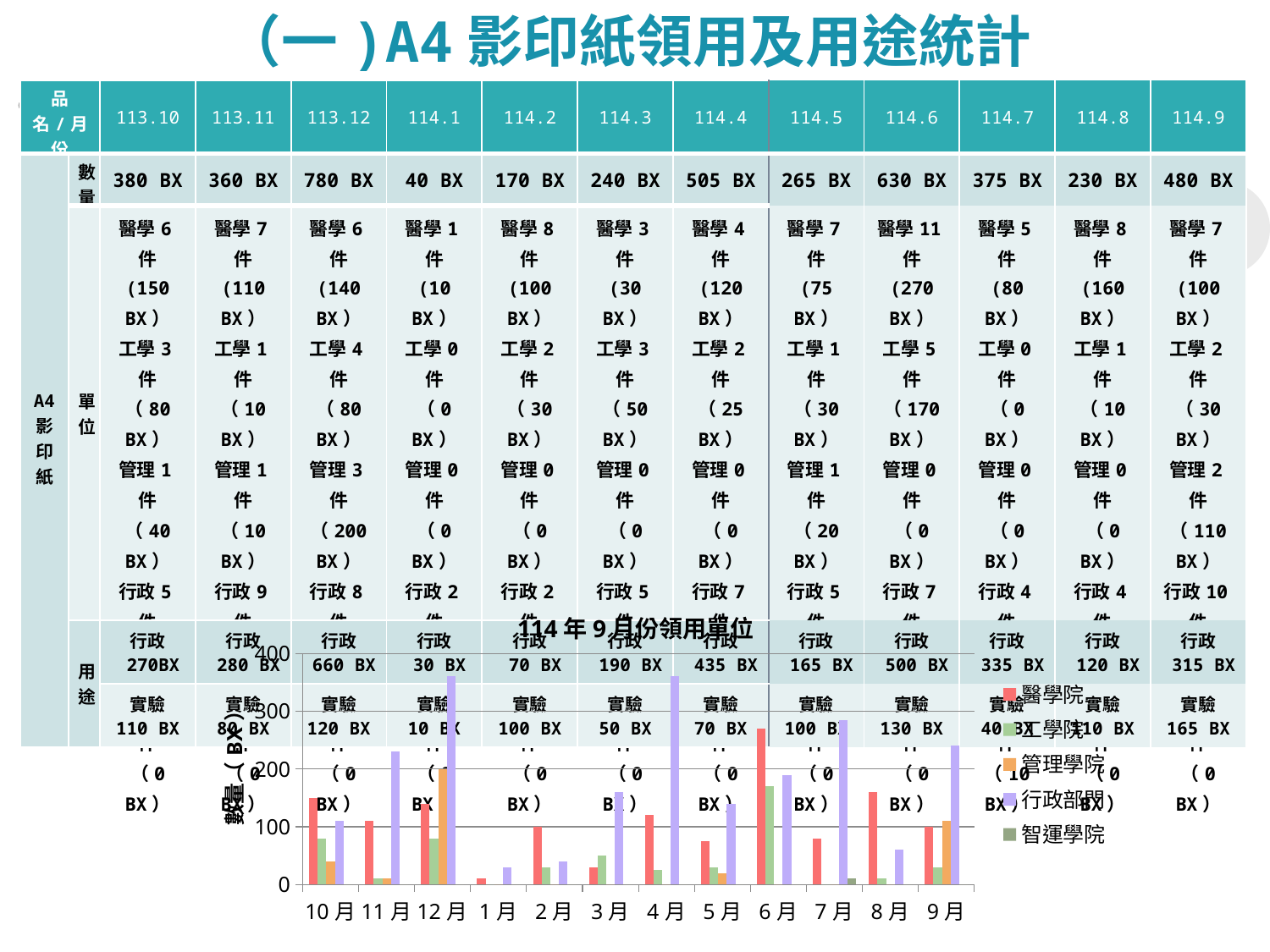
Is the value for 工學院 in 6月 greater or less than 100? greater Is the value for 醫學院 in 6月 greater or less than 200? greater What is the label on the chart's y axis? 數量（BX） In 12月, which is larger, the 行政部門 bar or the 醫學院 bar? 行政部門 What is the title of the chart? 114年9月份領用單位 In 8月, which is larger, the 醫學院 bar or the 行政部門 bar? 醫學院 How many months are shown along the x axis of the chart? 12 Is the value for 行政部門 in 12月 greater or less than 300? greater How many series does the chart legend list? 5 In which month is the 醫學院 bar the highest? 6月 What type of chart is shown on the slide? bar chart